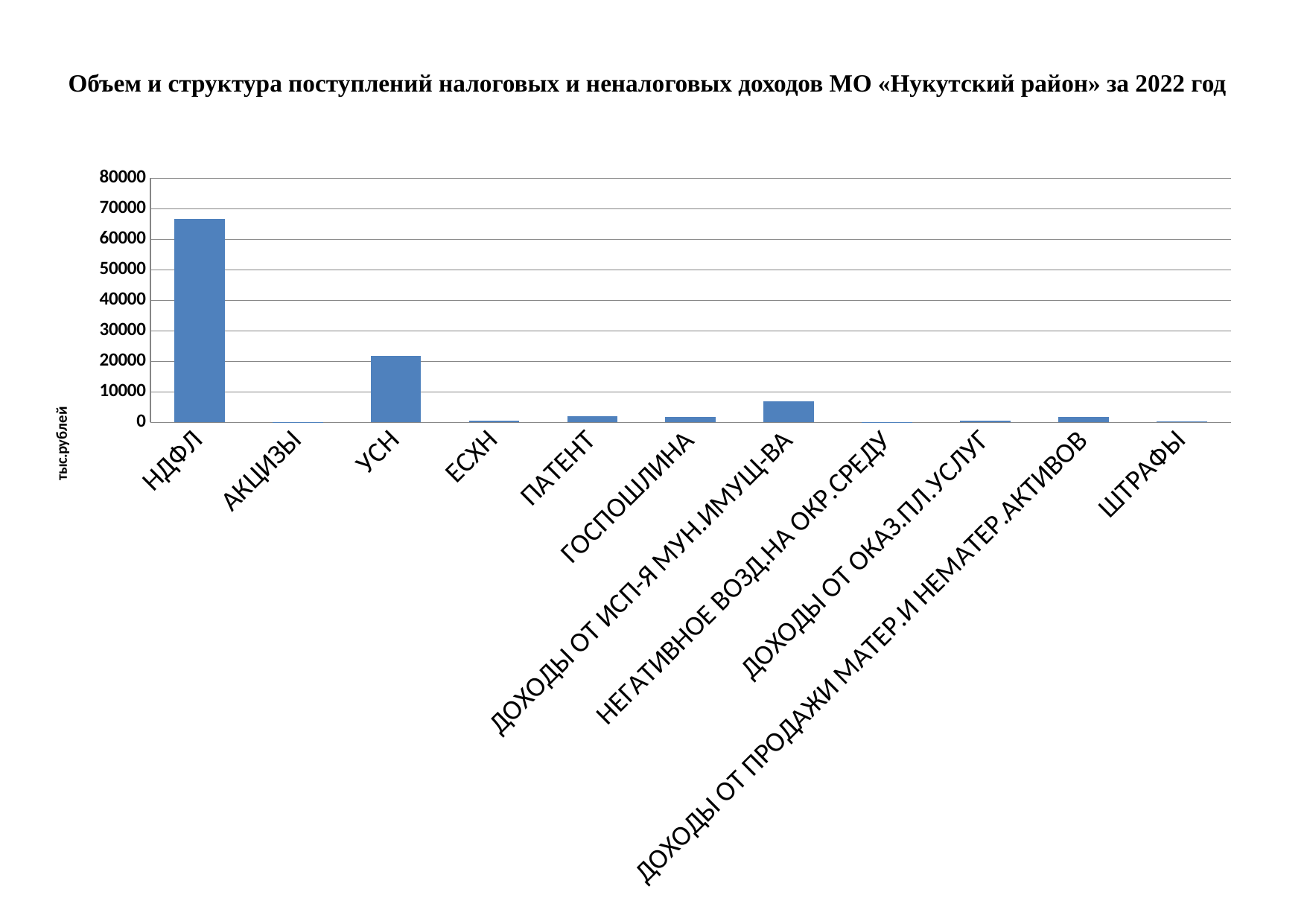
Is the value for НДФЛ greater or less than 60000? greater Which category has the highest value in the chart? НДФЛ What kind of chart is shown on the slide? Bar chart Which category has the second highest value in the chart? УСН Which is larger, the value for ДОХОДЫ ОТ ИСП-Я МУН.ИМУЩ-ВА or the value for ПАТЕНТ? ДОХОДЫ ОТ ИСП-Я МУН.ИМУЩ-ВА Is the value for УСН greater or less than 30000? less Which is larger, the value for НДФЛ or the value for УСН? НДФЛ How many categories are shown on the x axis of the chart? 11 Is the value for ДОХОДЫ ОТ ИСП-Я МУН.ИМУЩ-ВА greater or less than 10000? less What unit is given on the vertical axis label of the chart? тыс.рублей What is the title of the chart? Объем и структура поступлений налоговых и неналоговых доходов МО «Нукутский район» за 2022 год